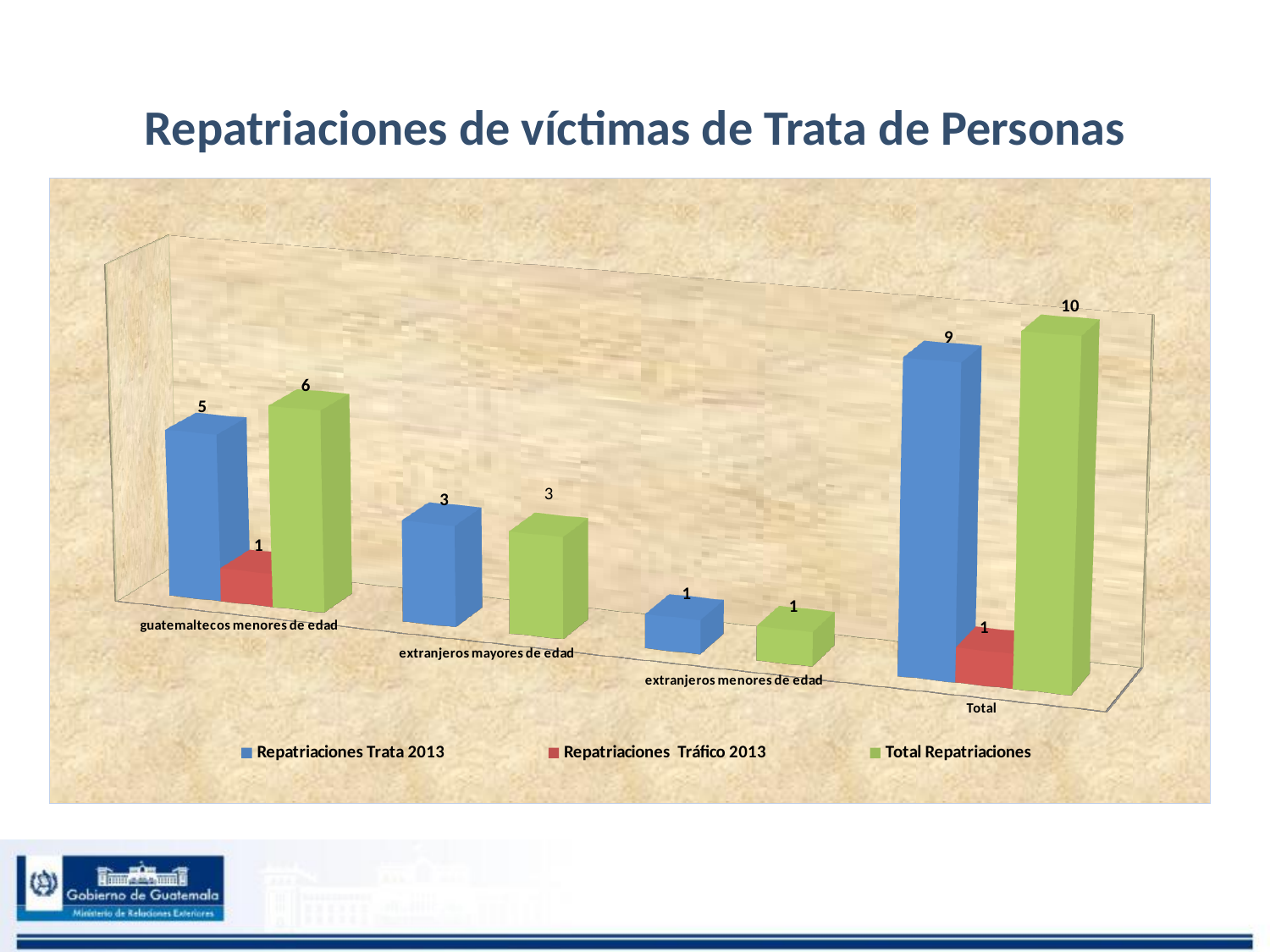
Excluding the Total category, which category has the lowest Total Repatriaciones value? extranjeros menores de edad What is the value of Repatriaciones Trata 2013 for extranjeros menores de edad? 1 Excluding the Total category, which category has the highest Repatriaciones Trata 2013 value? guatemaltecos menores de edad Which is larger for guatemaltecos menores de edad: Repatriaciones Trata 2013 or Total Repatriaciones? Total Repatriaciones What is the value of Repatriaciones Tráfico 2013 for guatemaltecos menores de edad? 1 What is the difference between Total Repatriaciones and Repatriaciones Trata 2013 for the Total category? 1 What type of chart is shown on the slide? bar chart What is the value of Total Repatriaciones for the Total category? 10 What is the value of Repatriaciones Trata 2013 for guatemaltecos menores de edad? 5 What is the value of Total Repatriaciones for extranjeros mayores de edad? 3 How many categories are shown on the x axis? 4 How many series does the legend list? 3